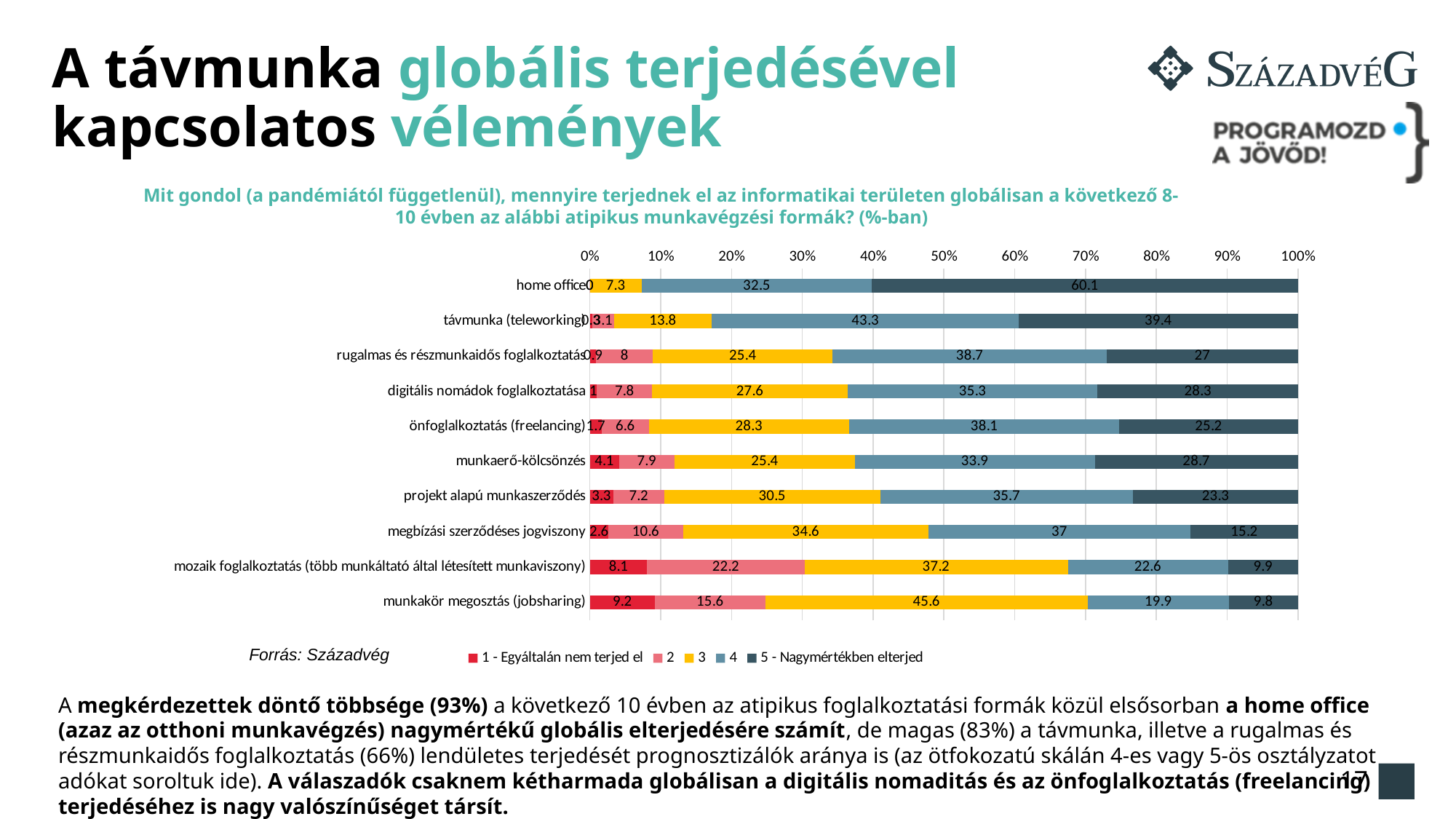
What is the difference between the "5 - Nagymértékben elterjed" values for "home office" and "távmunka (teleworking)"? 20.7 Which has a larger value for series "3": "mozaik foglalkoztatás" or "munkakör megosztás (jobsharing)"? munkakör megosztás (jobsharing) Which category has the highest value for the "1 - Egyáltalán nem terjed el" series? munkakör megosztás (jobsharing) What kind of chart is shown on the slide? Stacked bar chart Which category has the highest value for series "3"? munkakör megosztás (jobsharing) What is the value of series "2" for "mozaik foglalkoztatás (több munkáltató által létesített munkaviszony)"? 22.2 How many series does the legend list? 5 What is the value of series "4" for "távmunka (teleworking)"? 43.3 Which category has the highest value for the "5 - Nagymértékben elterjed" series? home office What is the value of series "3" for "munkakör megosztás (jobsharing)"? 45.6 How many categories are shown in the chart? 10 What is the value of the "5 - Nagymértékben elterjed" series for "home office"? 60.1